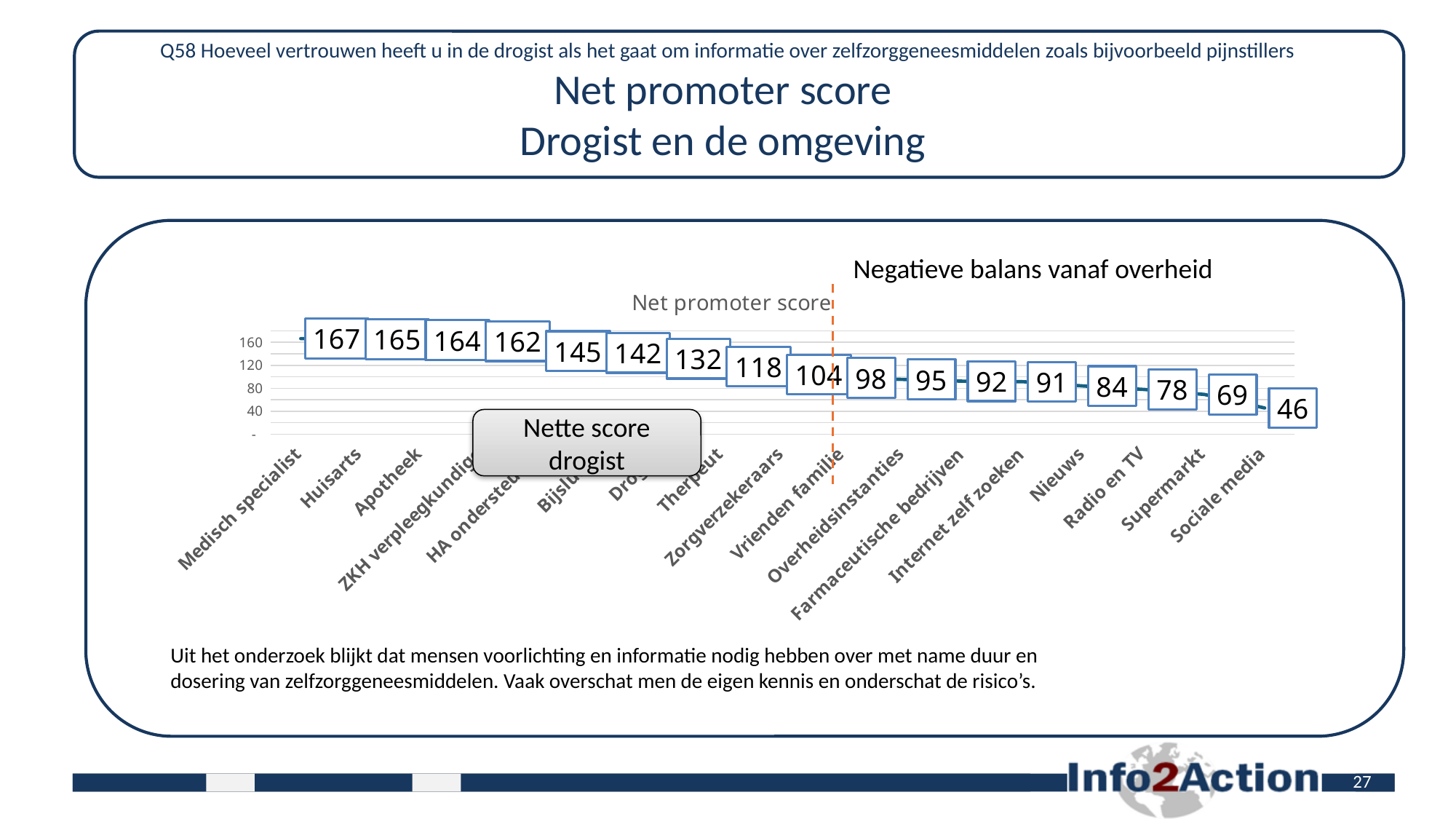
What is the net promoter score for Nieuws? 84 Which has a higher net promoter score, Supermarkt or Radio en TV? Radio en TV What is the difference between the net promoter scores of Medisch specialist and Sociale media? 121 What is the net promoter score for Sociale media? 46 What is the net promoter score for Therapeut? 118 Which category has the highest net promoter score? Medisch specialist Which category has the lowest net promoter score? Sociale media Do the net promoter scores rise or fall from left to right along the x axis? fall What is the net promoter score for Medisch specialist? 167 What is the net promoter score for Zorgverzekeraars? 104 What kind of chart is shown on the slide? line chart How many categories are plotted in the chart? 17